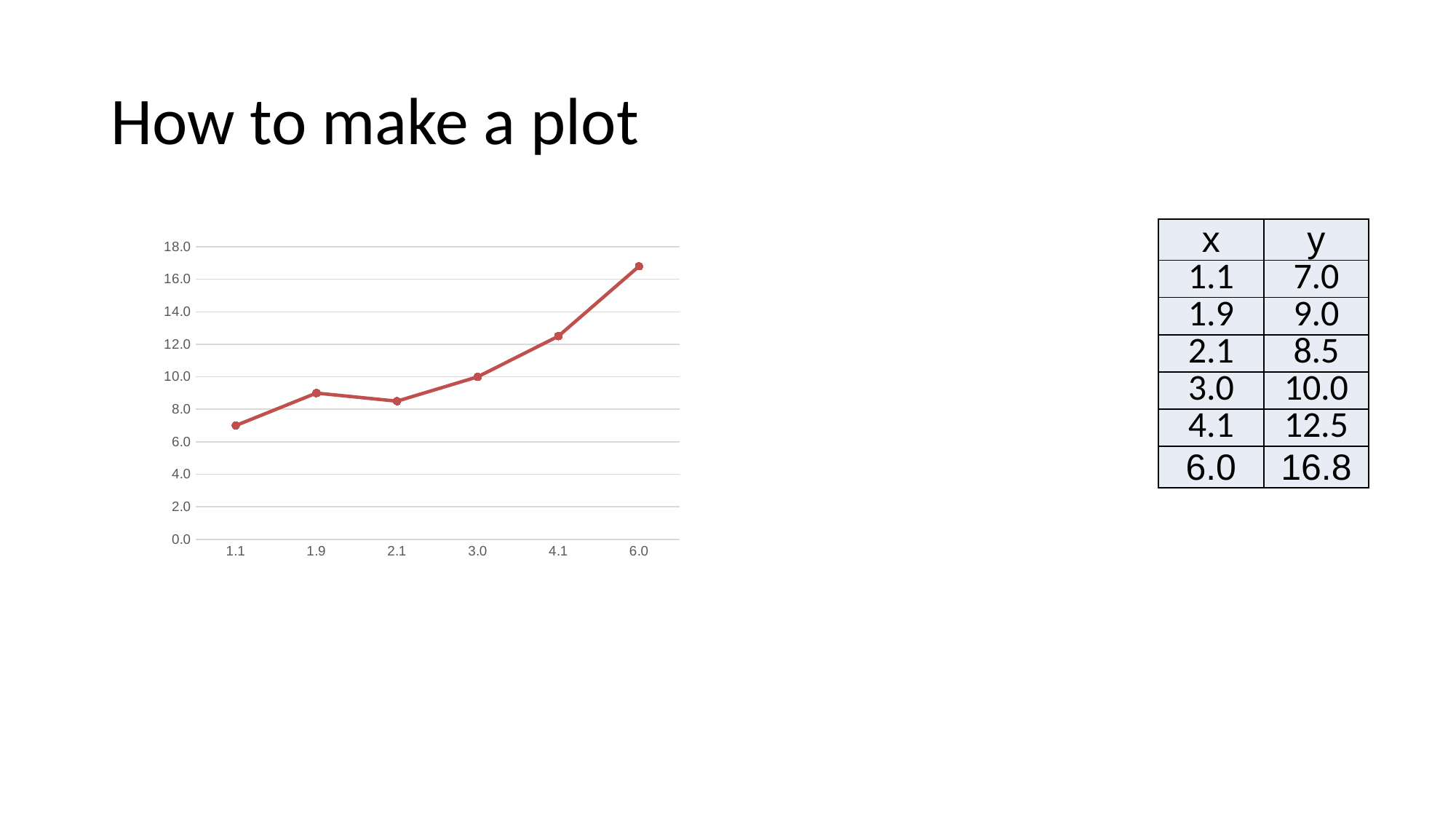
What type of chart is shown on the slide? line chart At which x value is y highest? 6.0 What is the y value at x = 6.0? 16.8 How many data points are plotted on the line chart? 6 At which x value is y lowest? 1.1 Which has the larger y value, x = 1.9 or x = 2.1? 1.9 What is the y value at x = 1.1? 7.0 Overall, do the y values rise or fall as x increases along the x axis? rise Is the y value at x = 4.1 greater or less than 12.0? greater What is the difference between the y values at x = 6.0 and x = 4.1? 4.3 What is the highest value labelled on the y axis of the chart? 18.0 What is the y value at x = 3.0? 10.0